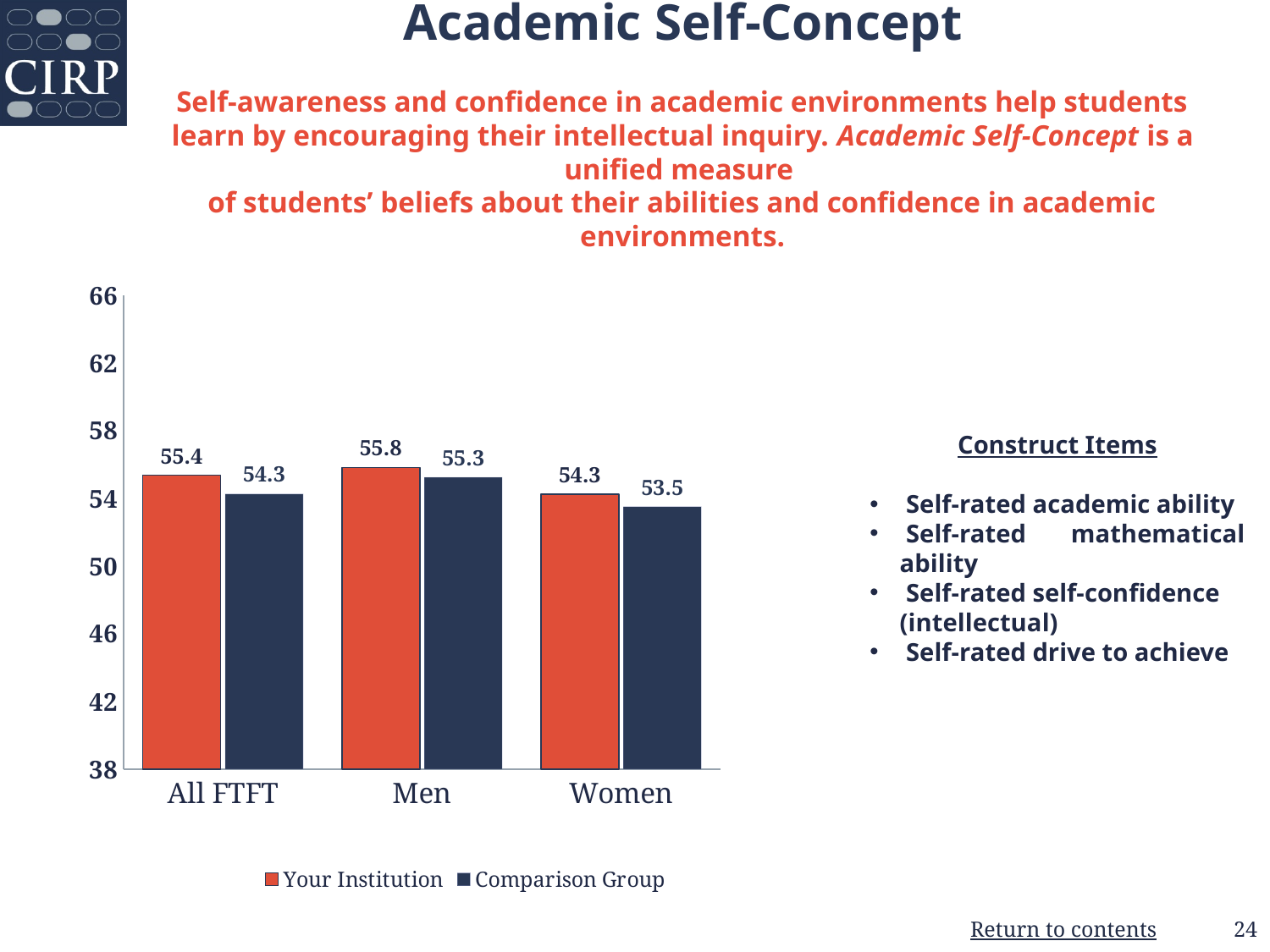
What is the value for Your Institution in the All FTFT category? 55.4 What kind of chart is shown on the slide? bar chart What is the value for Your Institution in the Men category? 55.8 What is the value for Comparison Group in the Women category? 53.5 How many categories are shown on the x axis? 3 Which category has the highest value for Your Institution? Men How many series does the legend list? 2 Which category has the lowest value for Comparison Group? Women What colour are the bars for Your Institution? orange-red What is the difference between Your Institution and Comparison Group in the All FTFT category? 1.1 Which is larger in the Women category: Your Institution or Comparison Group? Your Institution Is the value for Comparison Group in the Men category greater or less than 54? greater